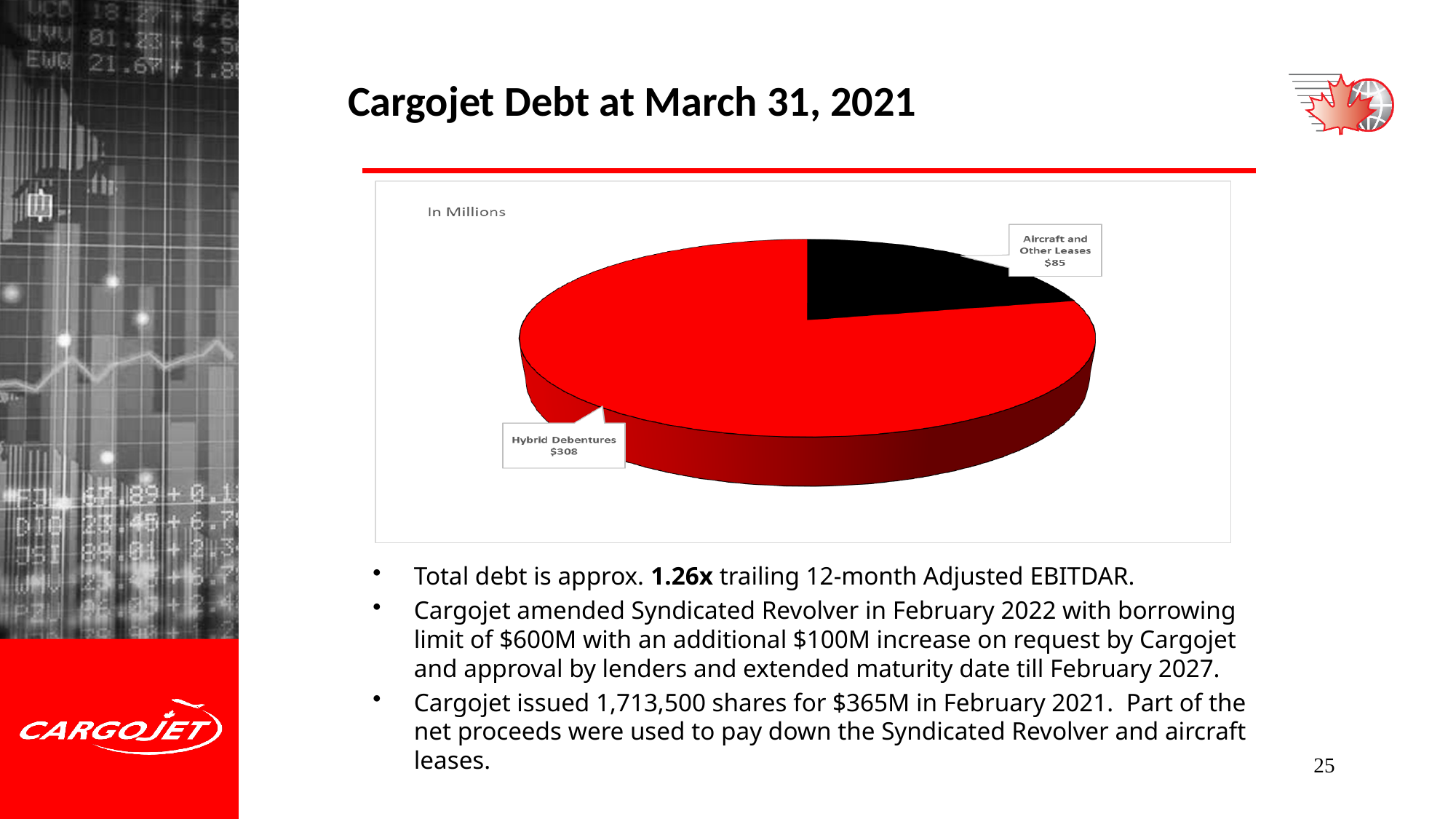
What is the total of the two slices shown in the pie chart? $393 Which slice of the pie chart is the largest? Hybrid Debentures How many slices does the pie chart have? 2 Which slice of the pie chart is the smallest? Aircraft and Other Leases What is the difference between Hybrid Debentures and Aircraft and Other Leases in the pie chart? $223 What unit label is shown at the top of the pie chart? In Millions What is the value for Hybrid Debentures in the pie chart? $308 What colour is the Aircraft and Other Leases slice in the pie chart? Black Which is larger in the pie chart, Hybrid Debentures or Aircraft and Other Leases? Hybrid Debentures What type of chart is shown on the slide? Pie chart What is the value for Aircraft and Other Leases in the pie chart? $85